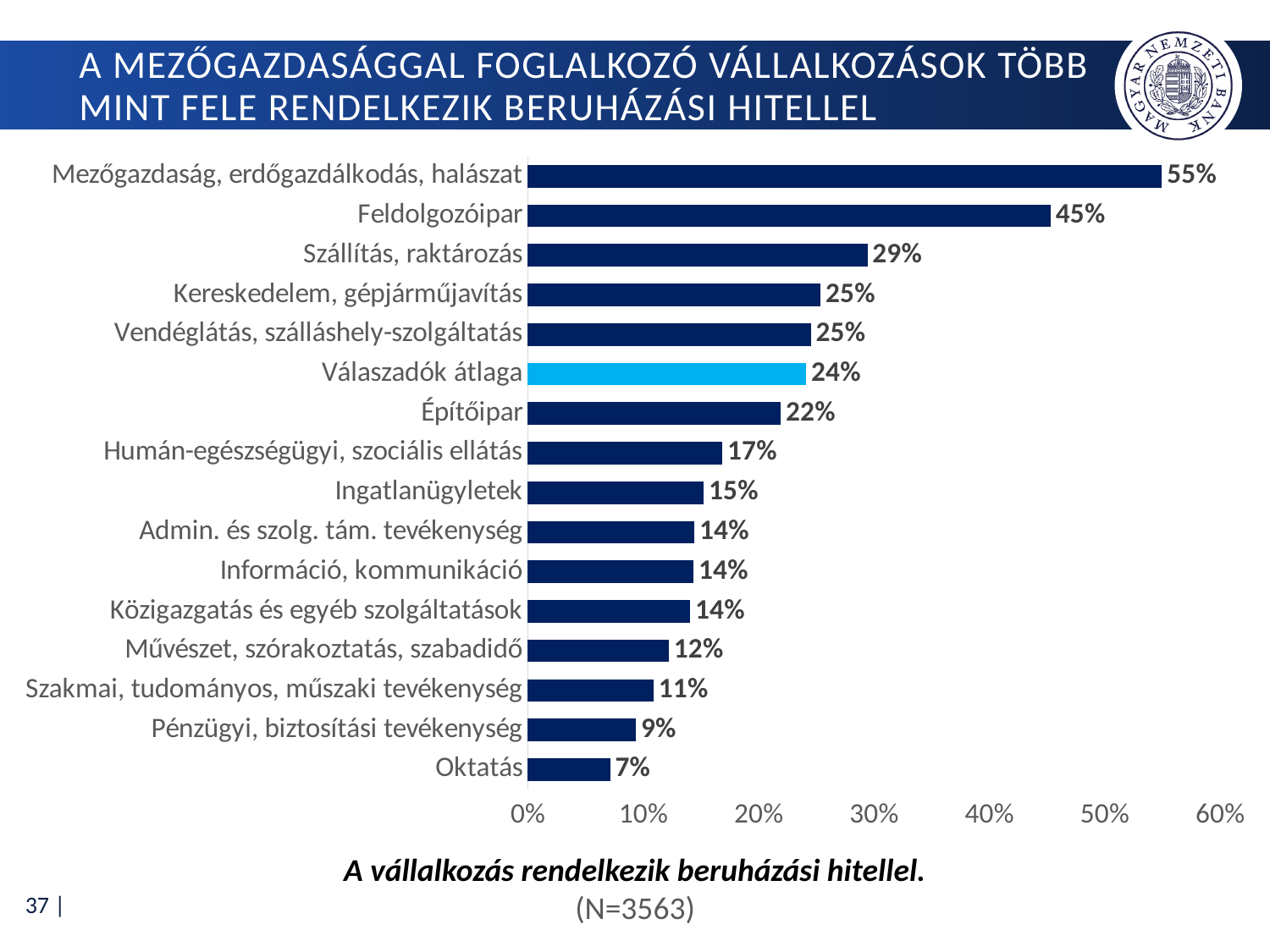
What is the difference between the values for Pénzügyi, biztosítási tevékenység and Oktatás? 2% What kind of chart is shown on the slide? bar chart Is the value for Humán-egészségügyi, szociális ellátás greater or less than 20%? less Which category has the highest value? Mezőgazdaság, erdőgazdálkodás, halászat Which bar is shown in a different (light blue) colour from the others? Válaszadók átlaga Which is larger, the value for Szállítás, raktározás or the value for Építőipar? Szállítás, raktározás What is the value for Válaszadók átlaga? 24% What is the value for Oktatás? 7% How many categories are shown in the chart? 16 What is the value for Feldolgozóipar? 45% Which category has the lowest value? Oktatás What is the difference between the values for Mezőgazdaság, erdőgazdálkodás, halászat and Feldolgozóipar? 10%